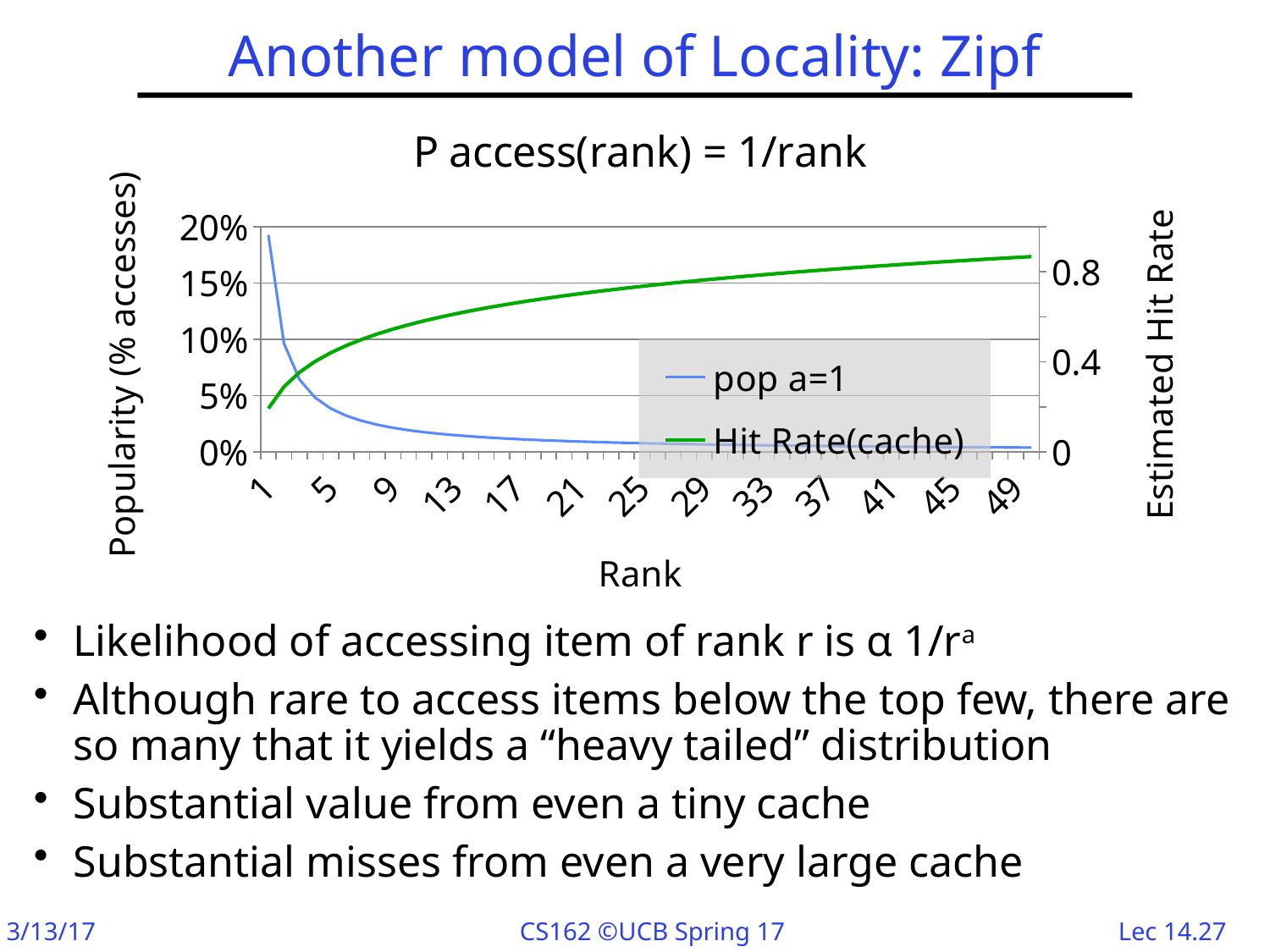
What is the title of the chart? P access(rank) = 1/rank Is the value of 'pop a=1' at rank 1 greater or less than 15%? greater Does the 'Hit Rate(cache)' series rise or fall as rank increases? rise What kind of chart is shown on the slide? line chart Is the value of 'pop a=1' at rank 25 greater or less than 5%? less Is the value of 'Hit Rate(cache)' at rank 1 greater or less than 0.4? less What is the label of the x axis of the chart? Rank How many series does the chart's legend list? 2 Does the 'pop a=1' series rise or fall as rank increases? fall